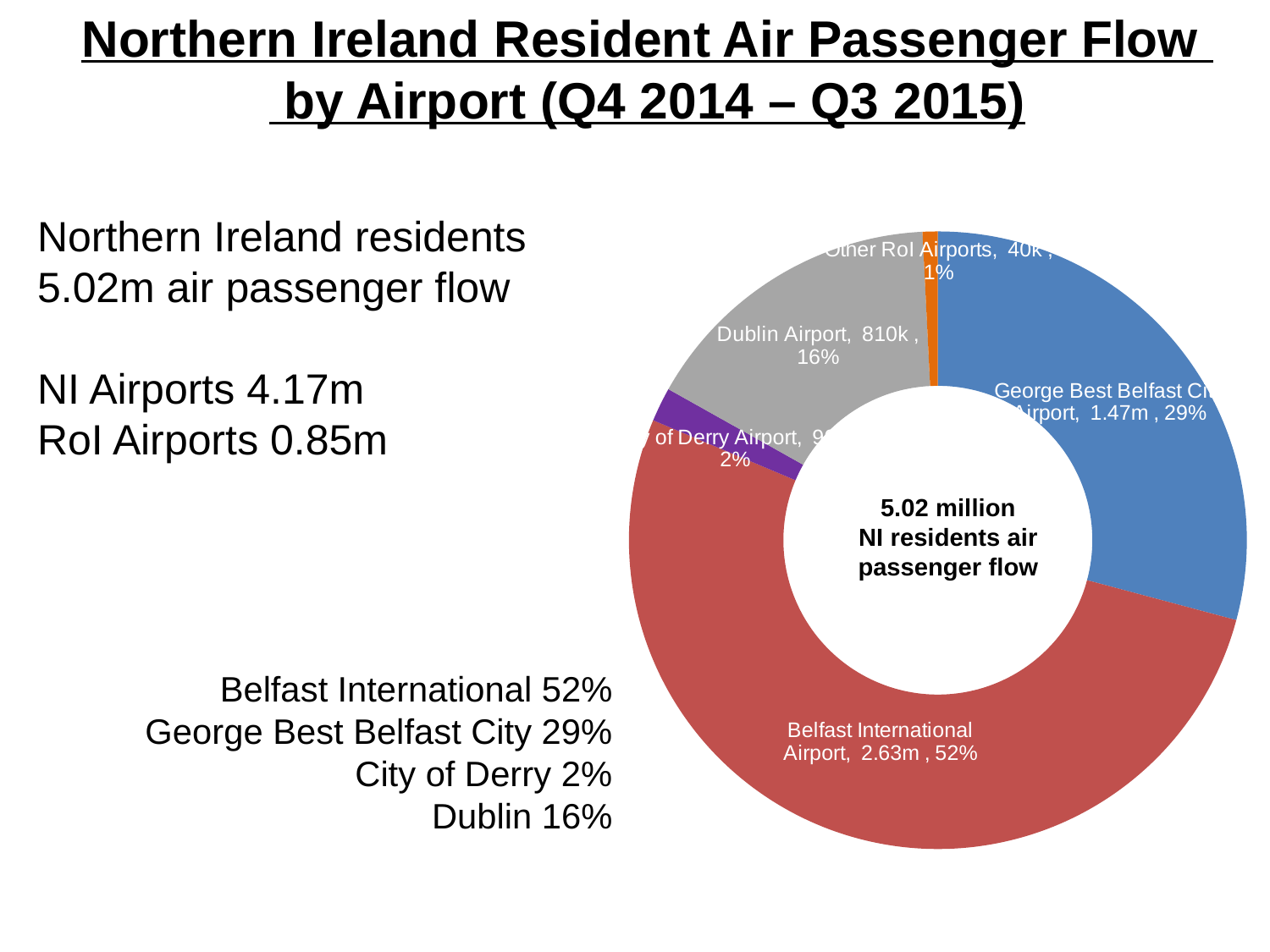
What kind of chart is shown on the slide? Doughnut (pie) chart What is the passenger flow value shown for Belfast International Airport? 2.63m What is the passenger flow value shown for George Best Belfast City Airport? 1.47m What share of the chart does City of Derry Airport represent? 2% What share of the chart does Dublin Airport represent? 16% How many airport categories are shown in the chart? 5 Which is larger, the share for George Best Belfast City Airport or the share for Dublin Airport? George Best Belfast City Airport What is the passenger flow value shown for Other RoI Airports? 40k What is the passenger flow value shown for Dublin Airport? 810k Which airport has the largest share of the chart? Belfast International Airport What total is written in the centre of the doughnut chart? 5.02 million NI residents air passenger flow Which airport has the smallest share of the chart? Other RoI Airports